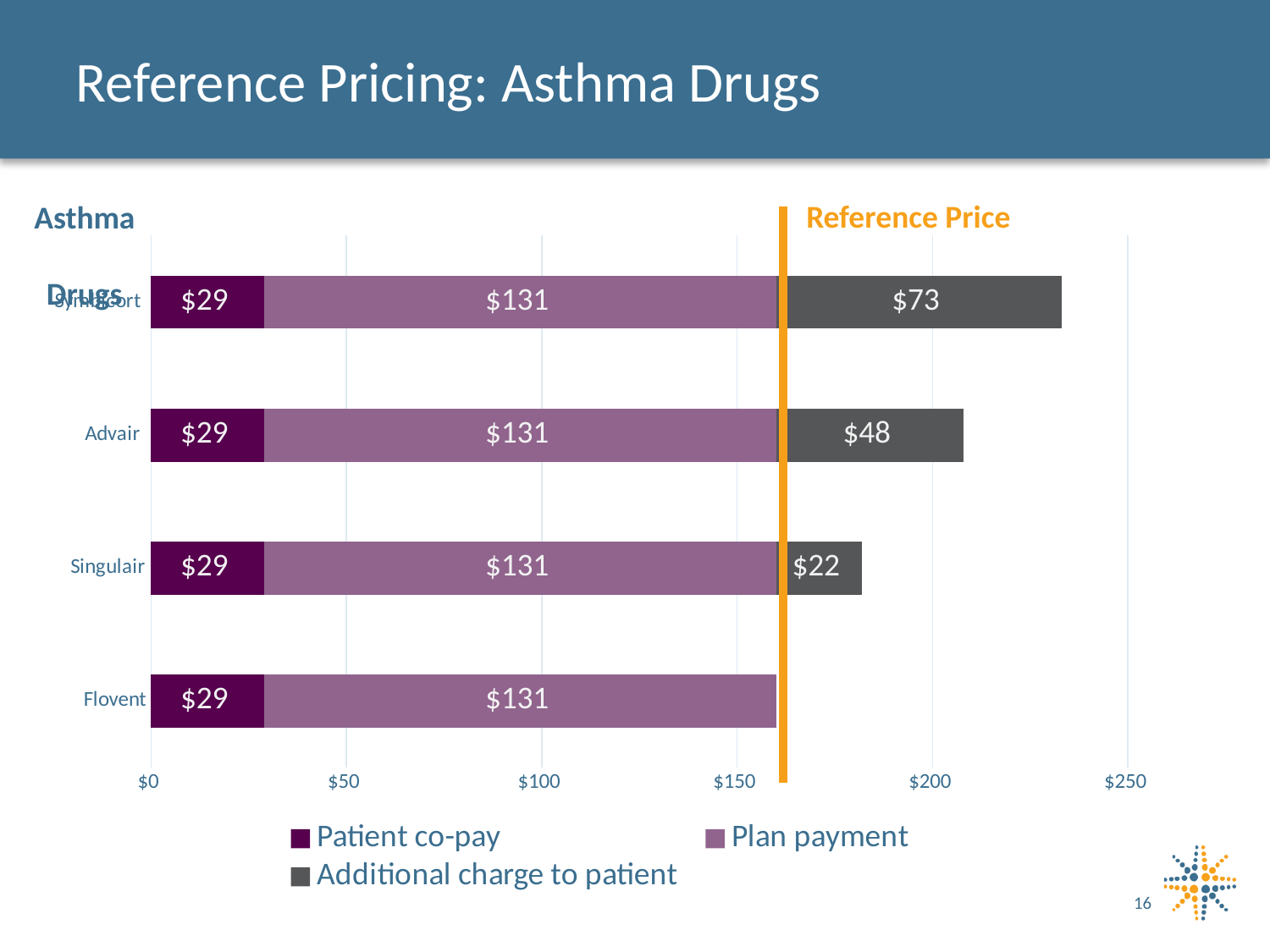
Is the total of the Singulair bar greater or less than $200? less What is the total of the stacked bar for Flovent? $160 What is the difference between the additional charge to patient for Advair and for Singulair? $26 How many series does the legend list? 3 What is the additional charge to patient for Advair? $48 Which drug has the highest additional charge to patient? Symbicort What is the plan payment for Flovent? $131 What kind of chart is shown on the slide? bar chart What is the patient co-pay for Singulair? $29 What does the orange vertical line on the chart represent? Reference Price What is the total of the stacked bar for Advair? $208 How many drugs are plotted on the chart? 4